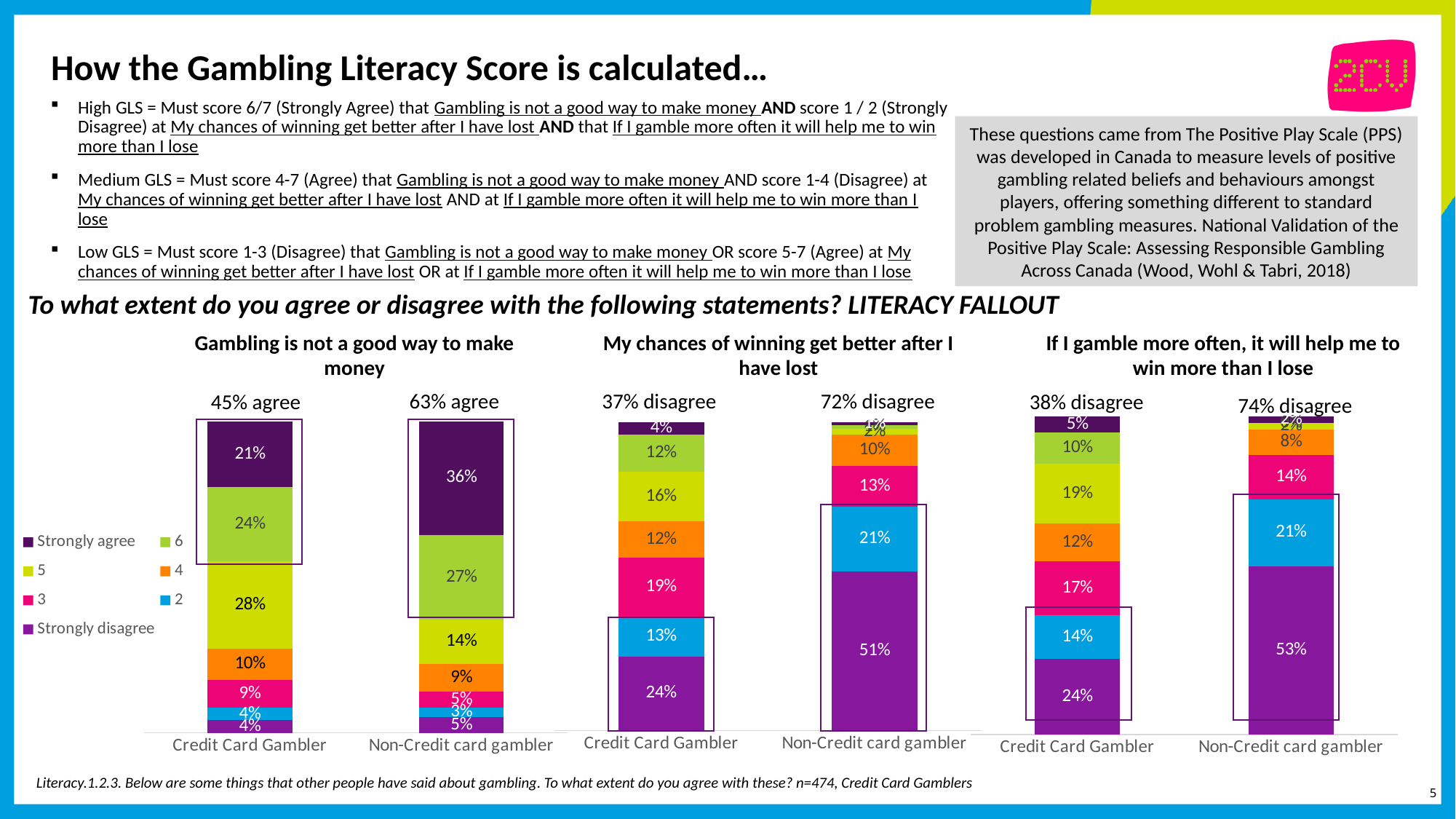
According to the annotation above the chart "Gambling is not a good way to make money", what percentage of Non-Credit card gamblers agree? 63% agree In the chart titled "Gambling is not a good way to make money", what percentage of Non-Credit card gamblers answered "Strongly agree"? 36% How many categories (bars) are shown in the chart titled "My chances of winning get better after I have lost"? 2 In the chart titled "Gambling is not a good way to make money", what is the difference between the "Strongly agree" percentages for Non-Credit card gamblers and Credit Card Gamblers? 15% In the chart titled "If I gamble more often, it will help me to win more than I lose", what percentage of Credit Card Gamblers answered "Strongly disagree"? 24% How many entries does the legend list for the charts on this slide? 7 In the chart titled "My chances of winning get better after I have lost", what percentage of Non-Credit card gamblers answered "Strongly disagree"? 51% In the chart titled "Gambling is not a good way to make money", what percentage of Credit Card Gamblers answered "Strongly agree"? 21% What kind of chart is used for "Gambling is not a good way to make money"? Stacked bar chart In the chart titled "My chances of winning get better after I have lost", which group has the larger "Strongly disagree" share: Credit Card Gamblers or Non-Credit card gamblers? Non-Credit card gamblers In the chart titled "If I gamble more often, it will help me to win more than I lose", what percentage of Non-Credit card gamblers gave a score of 2? 21% In the chart titled "If I gamble more often, it will help me to win more than I lose", what is the difference between the "Strongly disagree" percentages for Non-Credit card gamblers and Credit Card Gamblers? 29%